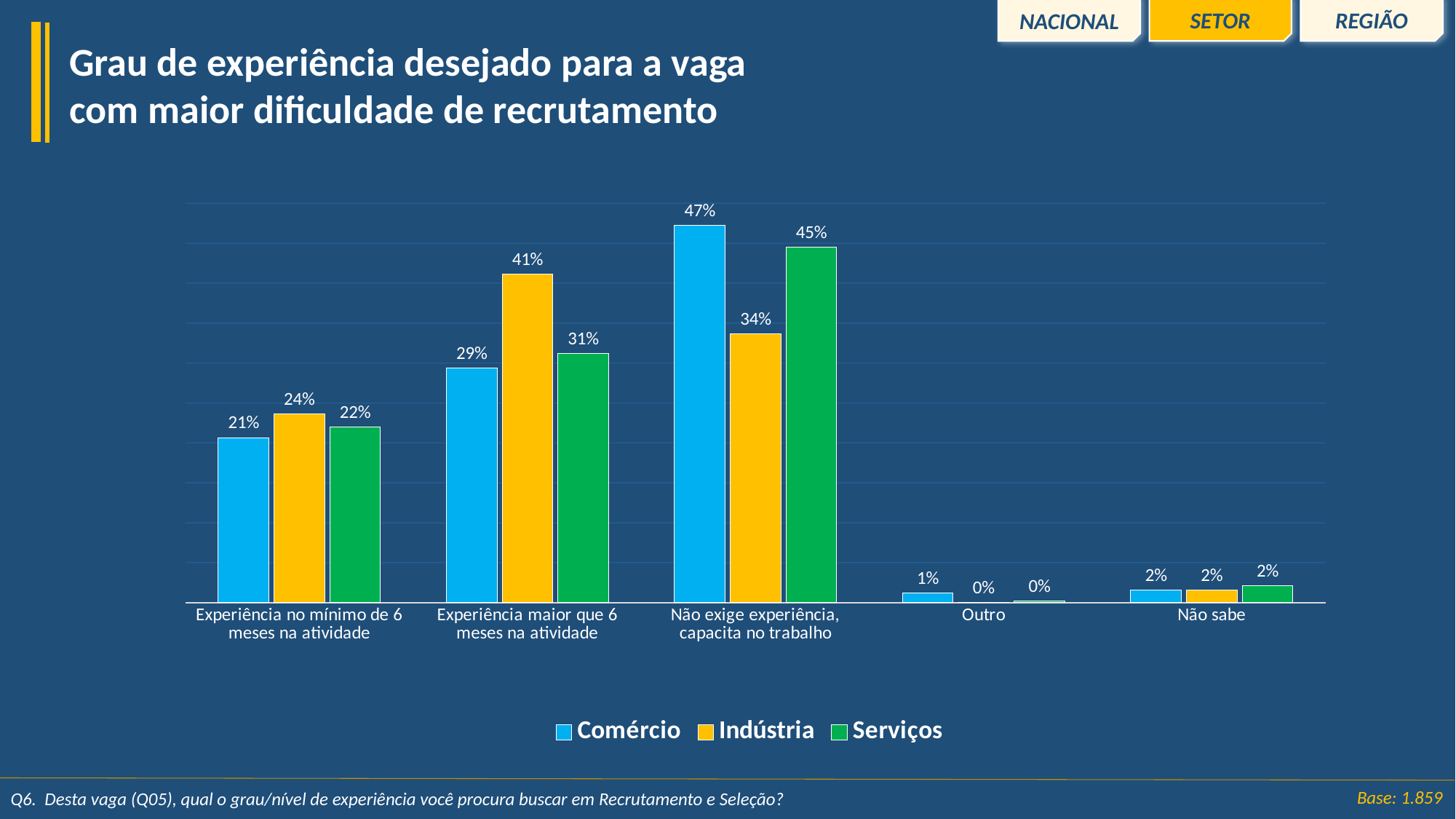
How many categories are shown on the x axis? 5 What is the value for Serviços in the category 'Experiência no mínimo de 6 meses na atividade'? 22% How many series does the legend list? 3 In the category 'Experiência maior que 6 meses na atividade', which is larger: Indústria or Serviços? Indústria What is the difference between the Comércio and Indústria values in the category 'Não exige experiência, capacita no trabalho'? 13% Which colour represents Serviços in the legend? Green Which category has the highest value for Indústria? Experiência maior que 6 meses na atividade What is the value for Indústria in the category 'Outro'? 0% What kind of chart is shown on the slide? Bar chart Which category has the lowest value for Comércio? Outro What is the value for Indústria in the category 'Experiência maior que 6 meses na atividade'? 41% What is the value for Comércio in the category 'Não exige experiência, capacita no trabalho'? 47%